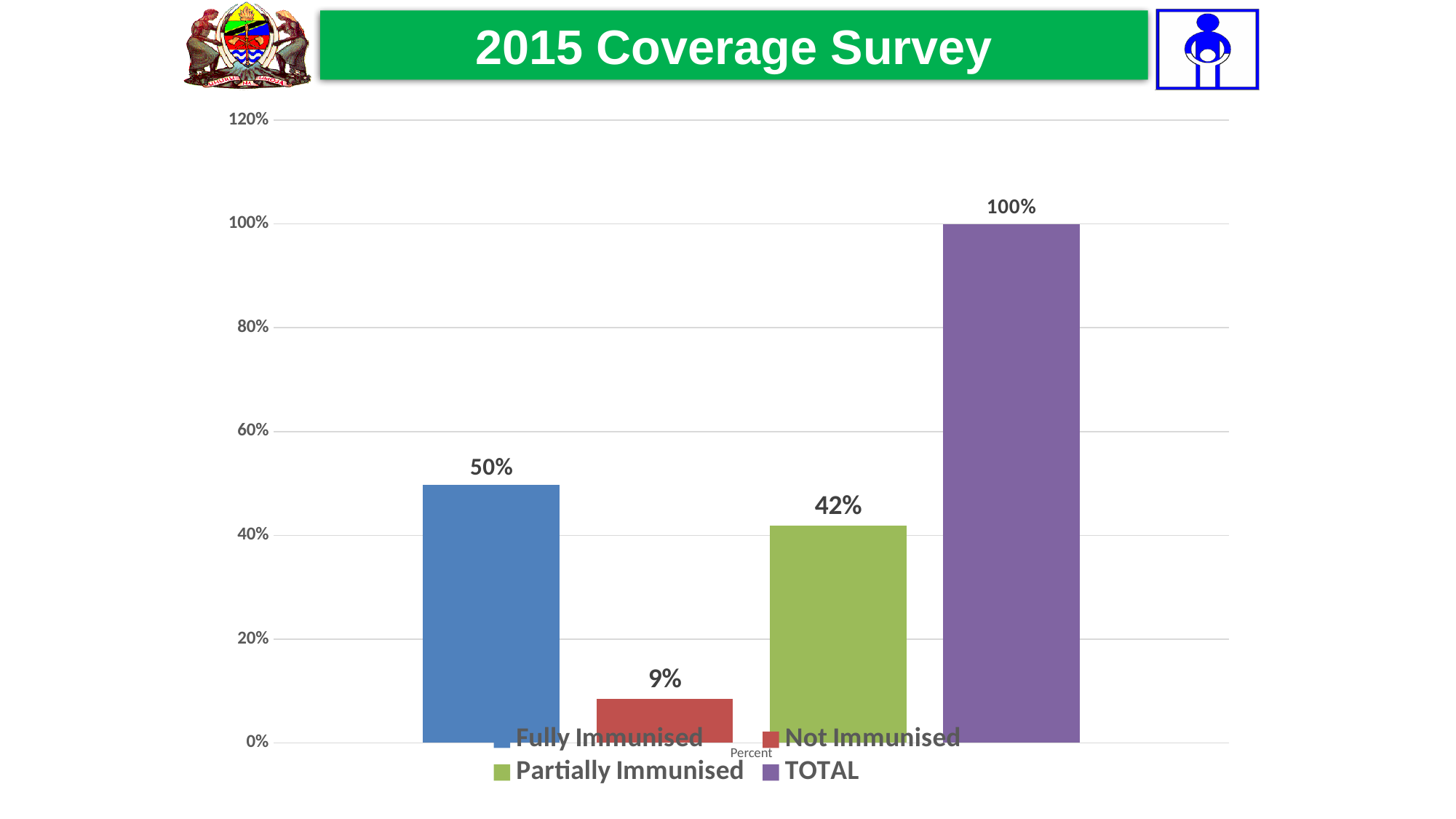
What is the value for Partially Immunised? 42% Which series has the highest value? TOTAL What is the value for Fully Immunised? 50% What is the title of the slide? 2015 Coverage Survey What is the difference between Fully Immunised and Partially Immunised? 8% Which is larger, Fully Immunised or Partially Immunised? Fully Immunised Is the value for Not Immunised greater or less than 20%? less Which series has the lowest value? Not Immunised What kind of chart is shown on the slide? bar chart What is the value for Not Immunised? 9% How many series does the legend list? 4 What is the value for TOTAL? 100%